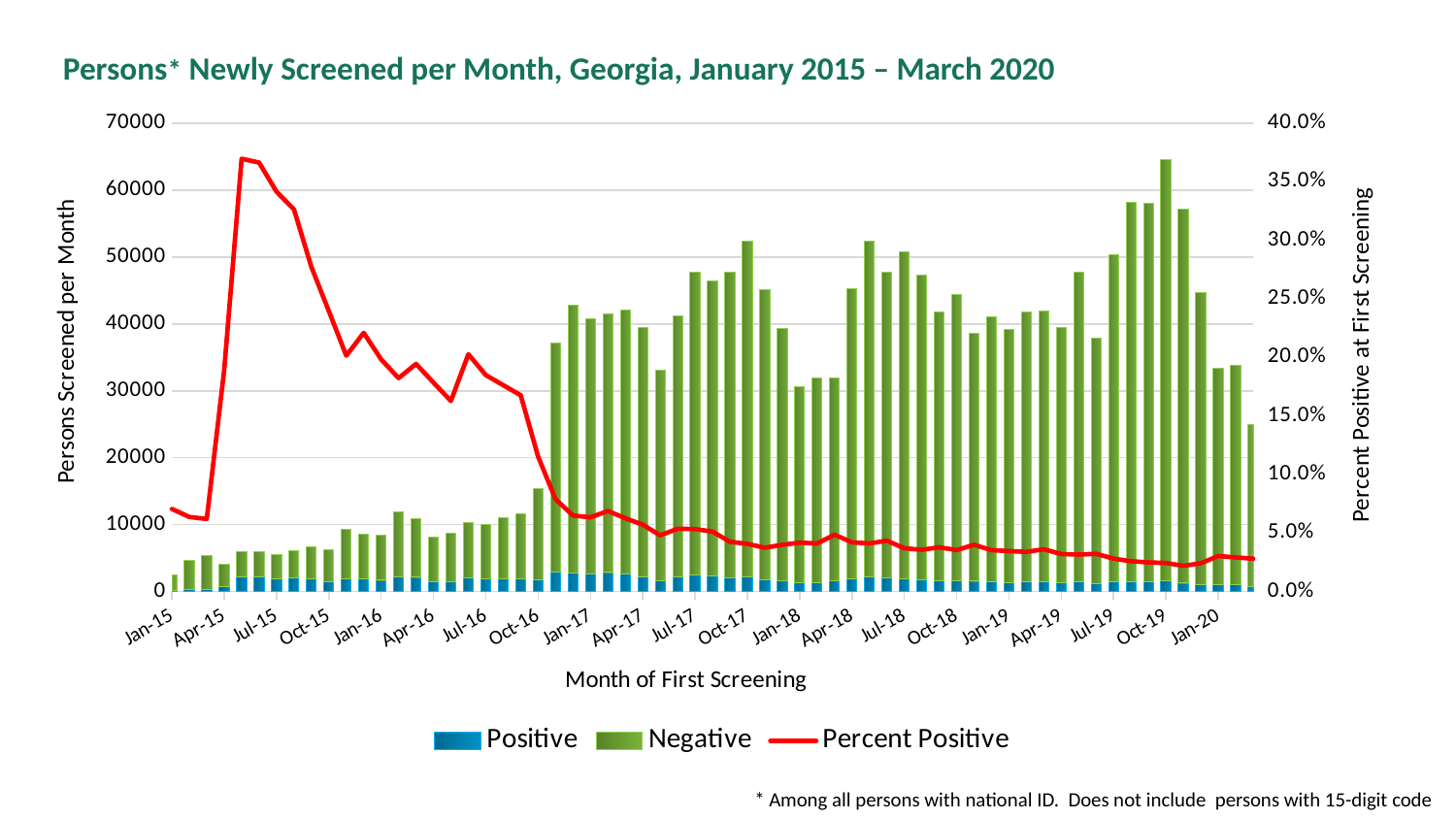
Is the total number of persons screened in Jan-15 greater or less than 10000? less Is the Percent Positive value higher in Jul-15 or Jul-19? Jul-15 How many month labels are shown on the x axis? 21 What kind of chart is this? Combination stacked bar and line chart Is the Percent Positive value for Jan-20 greater or less than 5.0%? less Is the total number of persons screened larger in Jan-15 or Jan-17? Jan-17 Is the Percent Positive value for Jul-15 greater or less than 30.0%? greater How many series does the legend list? 3 What is the title of the chart? Persons* Newly Screened per Month, Georgia, January 2015 – March 2020 What colour is the Percent Positive line? Red Does the Percent Positive line generally rise or fall from Jul-15 to Jan-20? fall